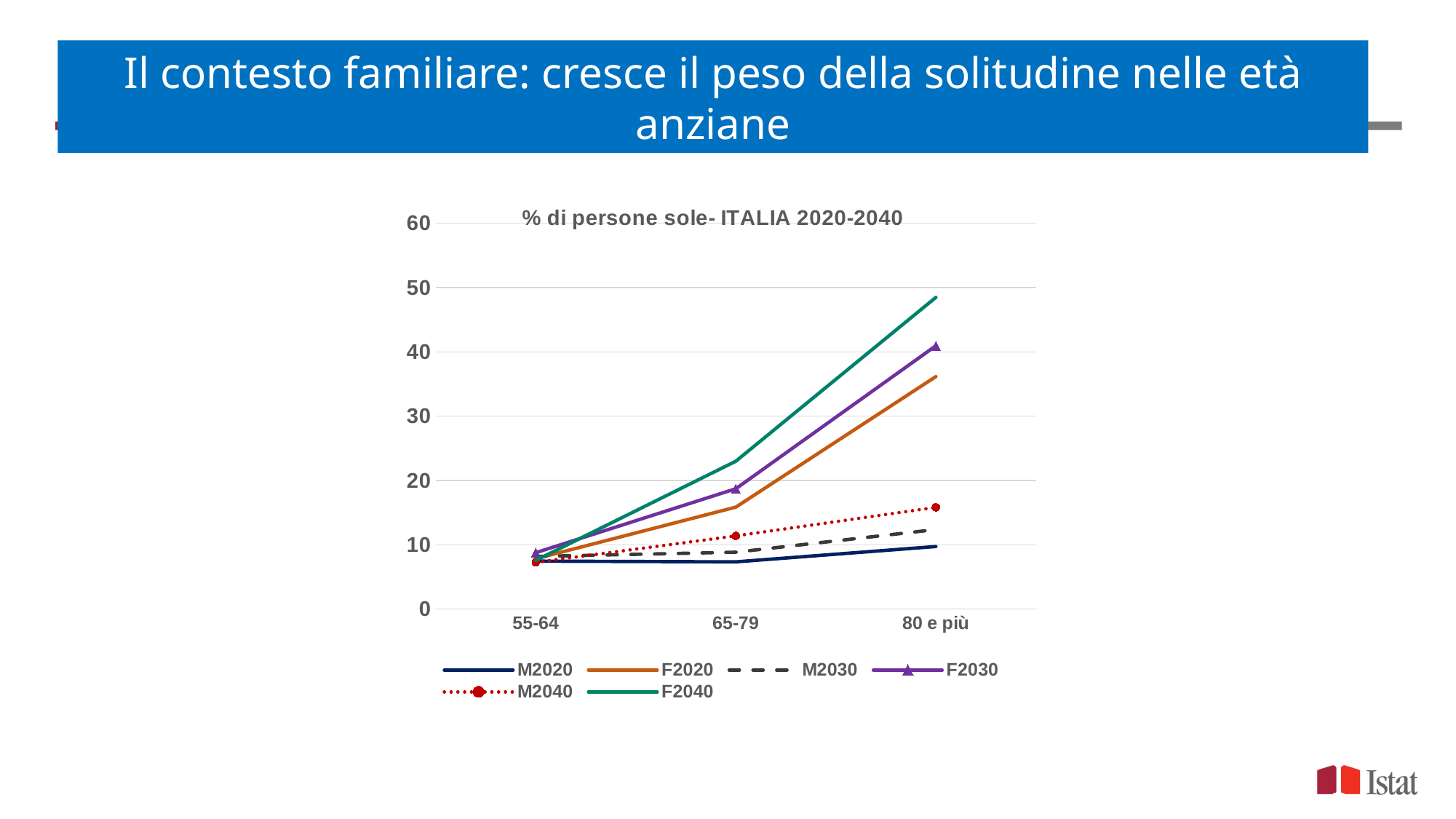
Is the value for F2040 at 80 e più greater or less than 40? greater Is the value for F2040 at 65-79 greater or less than 20? greater At 80 e più, which is larger: M2040 or M2030? M2040 How many series does the legend list? 6 What is the title of the chart? % di persone sole- ITALIA 2020-2040 At 80 e più, which is larger: F2030 or F2020? F2030 Which series has the lowest value for the 80 e più age group? M2020 Is the value for M2020 at 80 e più greater or less than 20? less How many age groups are shown on the x axis? 3 What kind of chart is shown on the slide? line chart Which series has the highest value for the 80 e più age group? F2040 Does the F2040 series rise or fall from 55-64 to 80 e più? rise